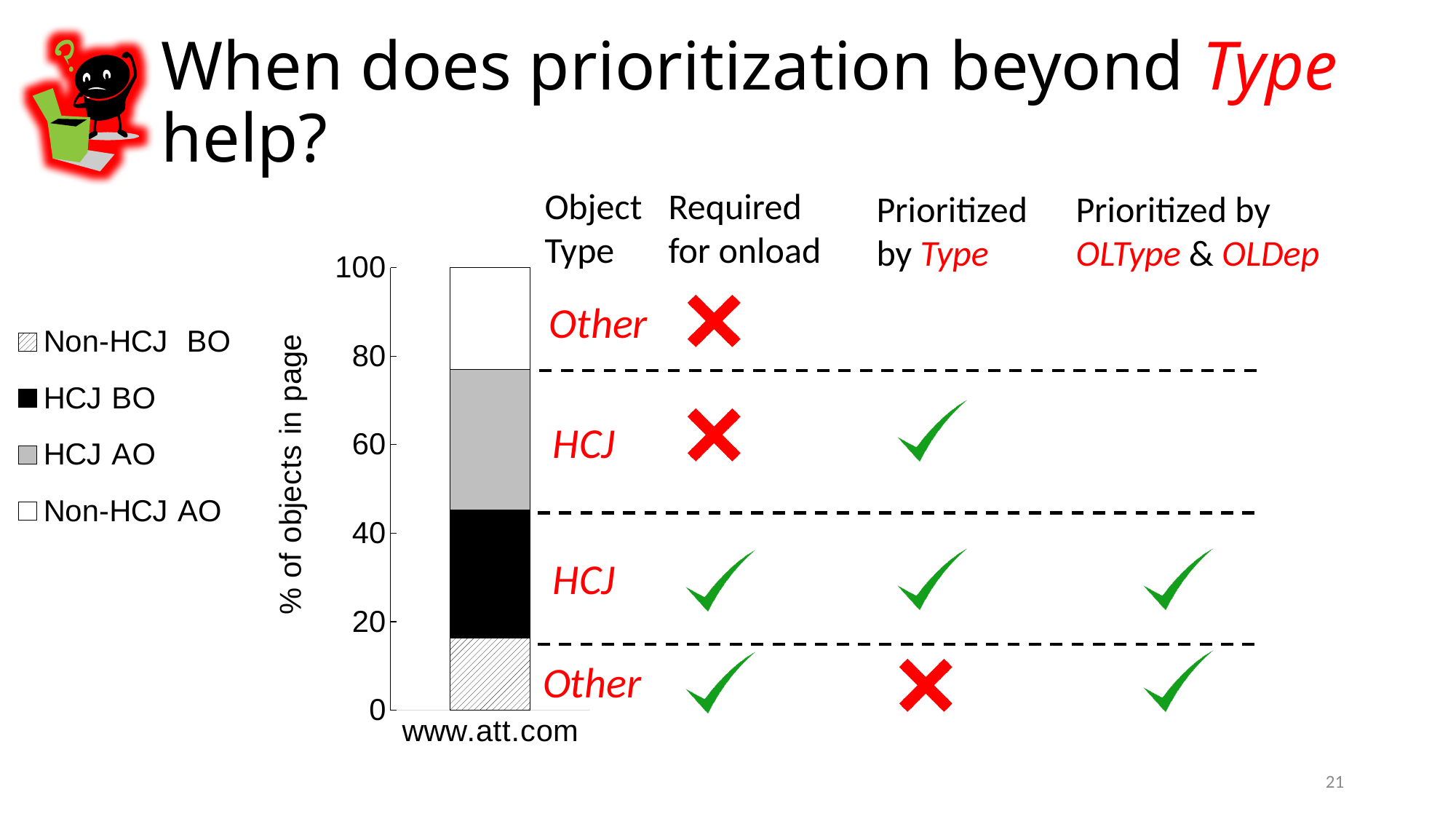
Which segment is larger, HCJ BO or Non-HCJ BO? HCJ BO How many series does the legend list? 4 What is the label of the vertical axis? % of objects in page How many bars (categories) are plotted in the chart? 1 Is the value of the HCJ AO segment greater or less than 40? less Is the value of the HCJ BO segment greater or less than 40? less What is the total height of the stacked bar for www.att.com? 100 Is the value of the HCJ BO segment greater or less than 20? greater What kind of chart is shown on the slide? stacked bar chart What is the category label under the bar? www.att.com Which segment is larger, HCJ AO or Non-HCJ BO? HCJ AO